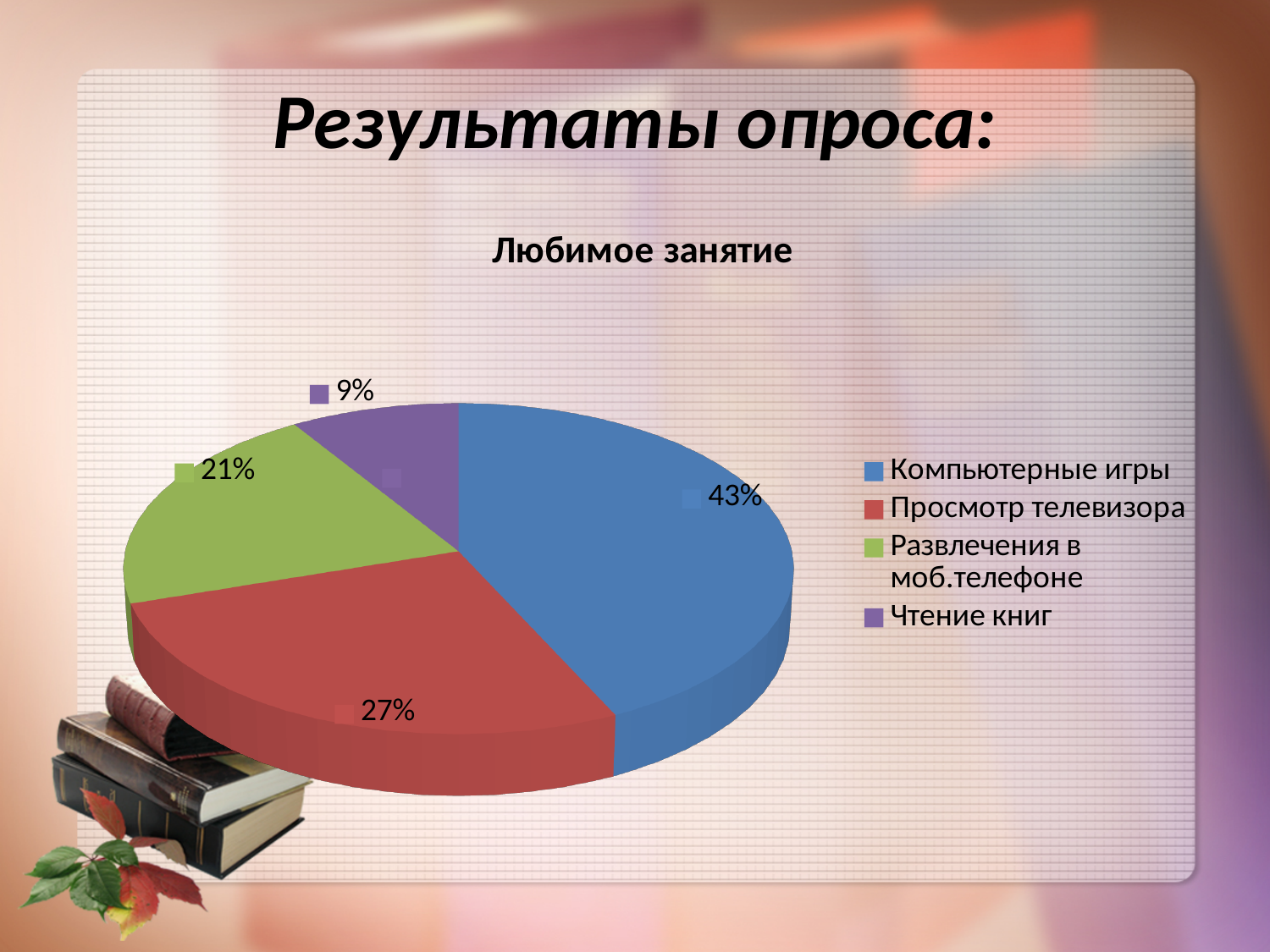
What colour is the slice for Просмотр телевизора? red What share of the pie does Чтение книг take? 9% Which category has the smallest share of the pie? Чтение книг How many categories does the pie chart have? 4 Which is larger, the share for Развлечения в моб.телефоне or the share for Чтение книг? Развлечения в моб.телефоне What share of the pie does Развлечения в моб.телефоне take? 21% What is the title of the chart? Любимое занятие What share of the pie does Просмотр телевизора take? 27% What type of chart is shown on the slide? pie chart What is the difference between the shares of Компьютерные игры and Просмотр телевизора? 16% Which category has the largest share of the pie? Компьютерные игры